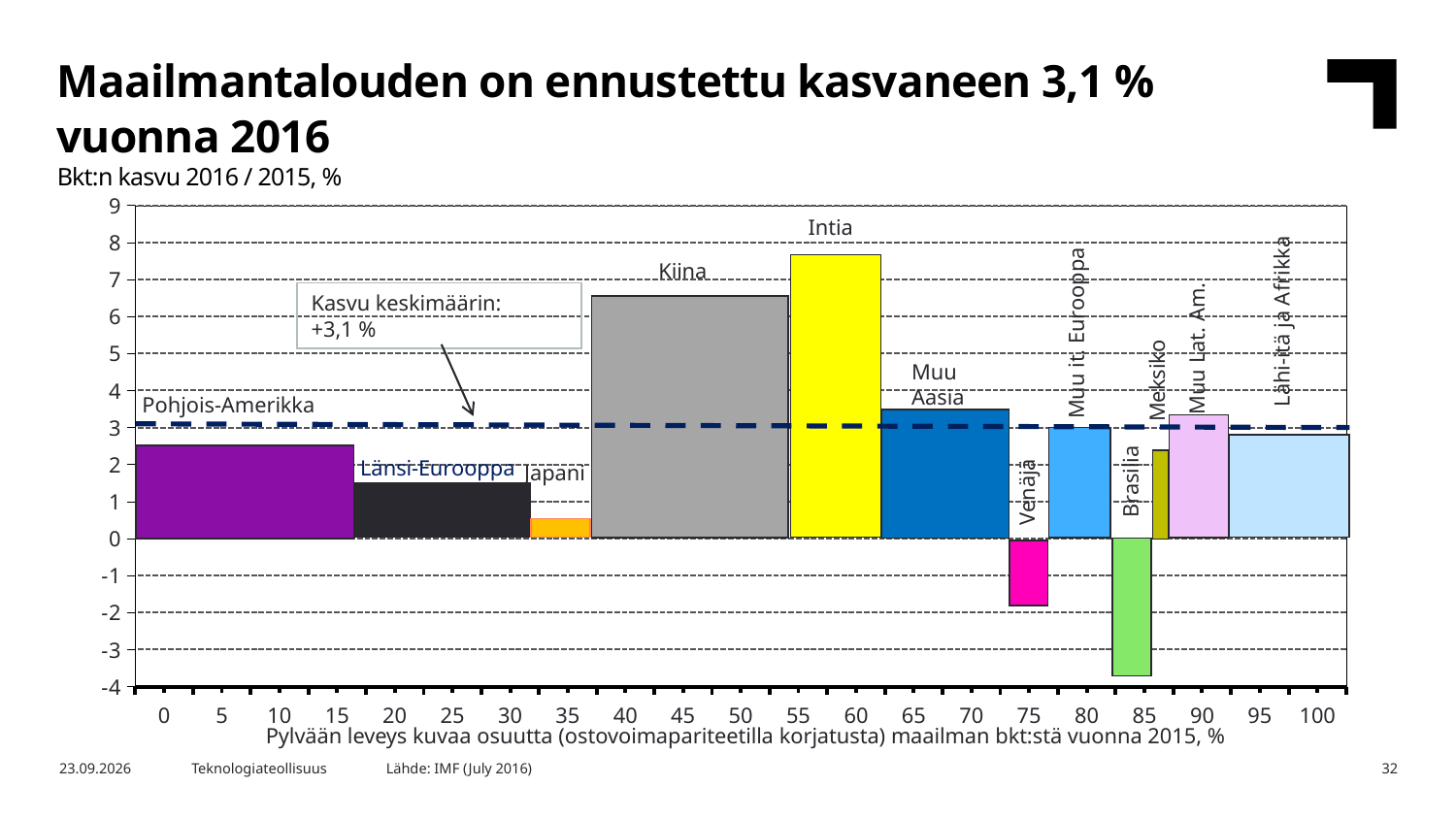
Which has the higher GDP growth, Kiina or Pohjois-Amerikka? Kiina Is the value for Japani greater or less than 1? less Which has the lower GDP growth, Venäjä or Brasilia? Brasilia Is the value for Kiina greater or less than 6? greater What kind of chart is shown on the slide? Bar chart Is the value for Pohjois-Amerikka greater or less than 2? greater Which region has the highest GDP growth in the chart? Intia Which has the higher GDP growth, Intia or Muu Aasia? Intia Which region has the lowest GDP growth in the chart? Brasilia How many regions are shown as bars in the chart? 12 What average growth value is marked by the dashed line in the chart? +3,1 %